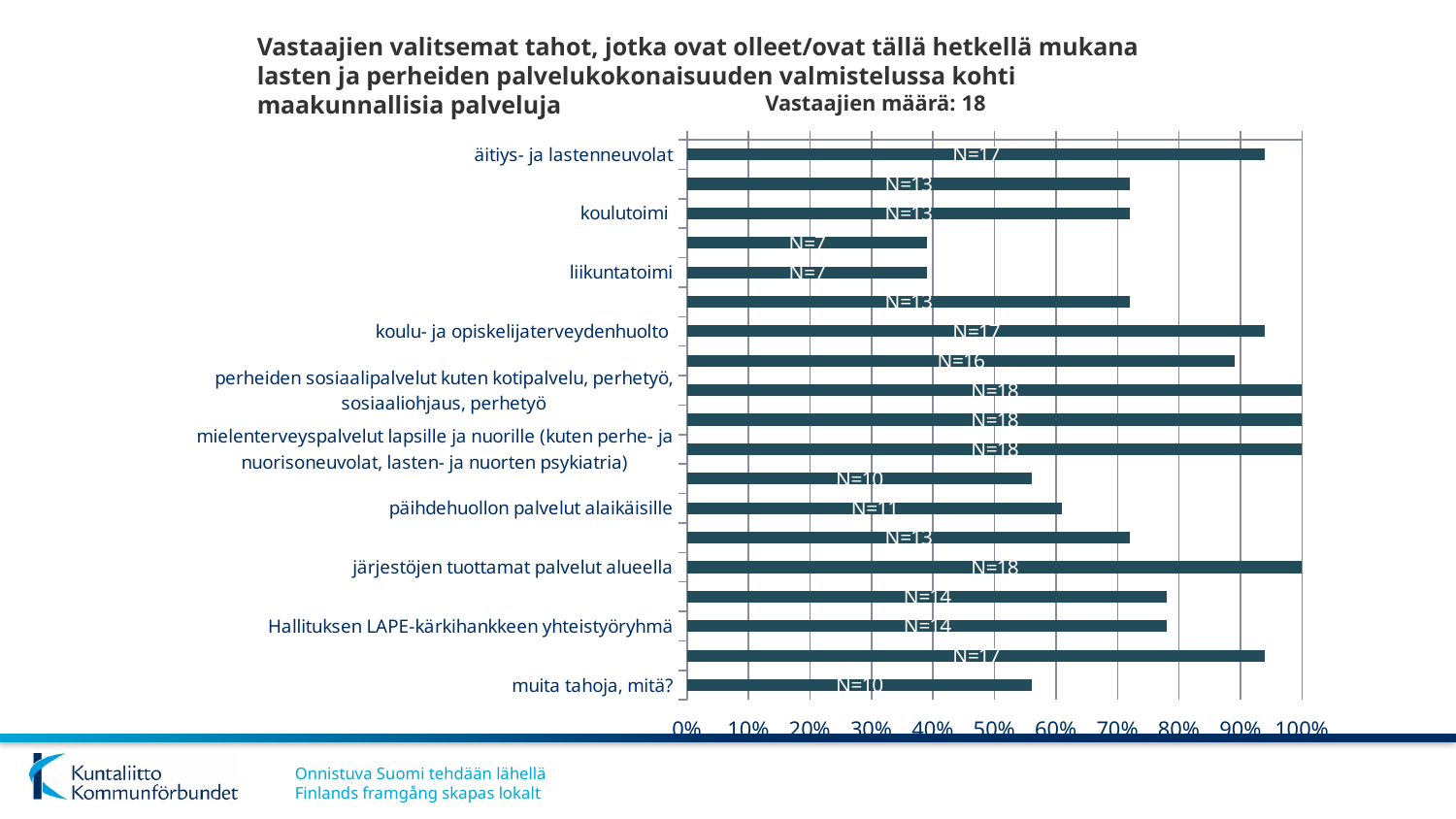
Which of the labelled categories has the smallest N value? liikuntatoimi Is the bar for 'äitiys- ja lastenneuvolat' greater or less than 90%? greater What is the data label on the bar for 'liikuntatoimi'? N=7 Is the bar for 'liikuntatoimi' greater or less than 50%? less What is the data label on the bar for 'Hallituksen LAPE-kärkihankkeen yhteistyöryhmä'? N=14 What kind of chart is shown on the slide? bar chart What is the data label on the bar for 'äitiys- ja lastenneuvolat'? N=17 What is the data label on the bar for 'muita tahoja, mitä?'? N=10 What is the data label on the bar for 'koulutoimi'? N=13 What is the data label on the bar for 'päihdehuollon palvelut alaikäisille'? N=11 What is the difference in N between 'äitiys- ja lastenneuvolat' and 'liikuntatoimi'? 10 Which has a larger N value, 'koulutoimi' or 'järjestöjen tuottamat palvelut alueella'? järjestöjen tuottamat palvelut alueella